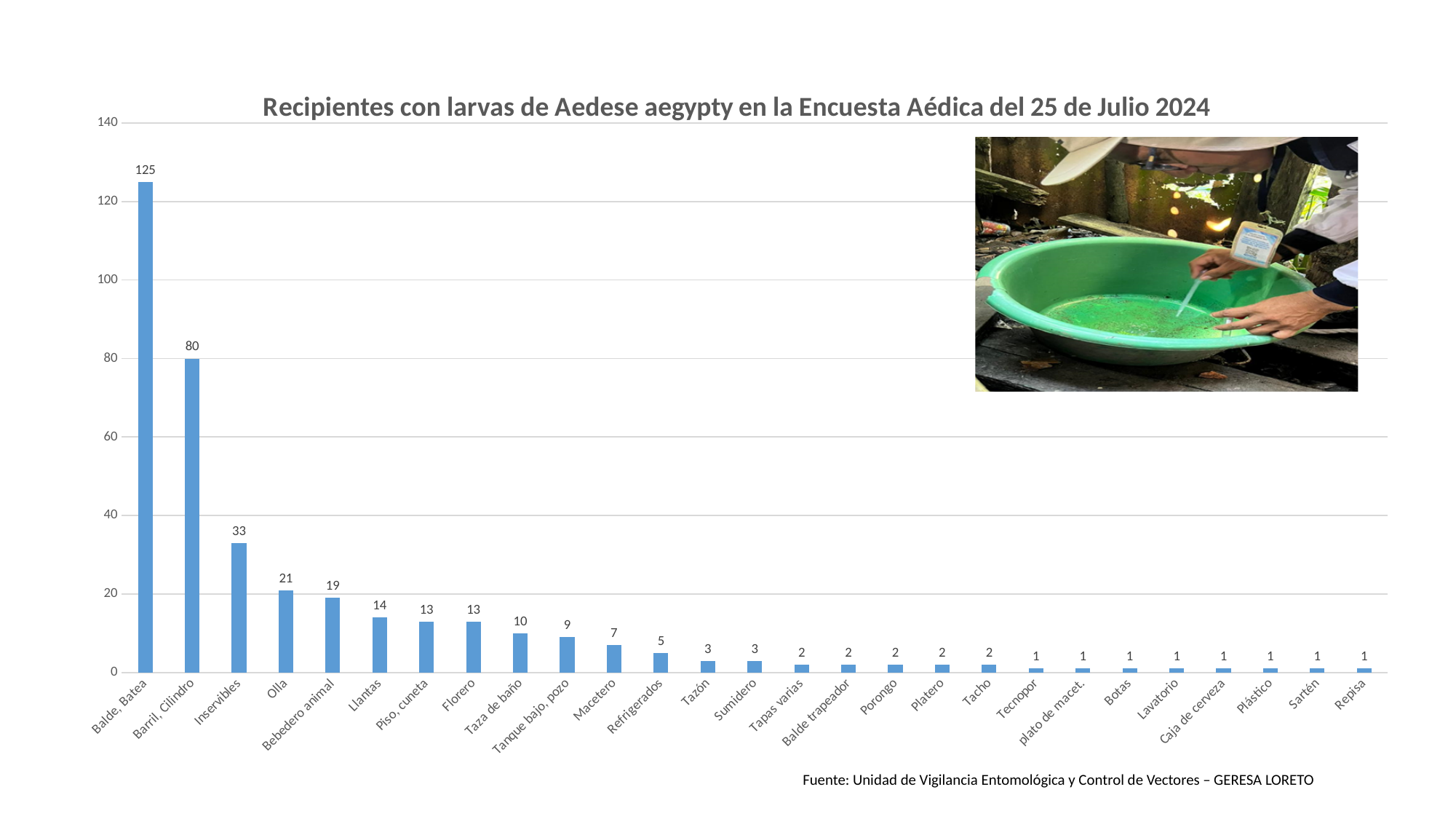
What is the value for Taza de baño? 10 What is the difference between the values for Inservibles and Olla? 12 Which is larger, the value for Llantas or the value for Macetero? Llantas What is the value for Bebedero animal? 19 How many categories are shown on the x axis? 27 Is the value for Inservibles greater or less than 40? less Which category has the highest value? Balde, Batea What is the value for Balde, Batea? 125 What is the title of the chart? Recipientes con larvas de Aedese aegypty en la Encuesta Aédica del 25 de Julio 2024 What is the difference between the values for Balde, Batea and Barril, Cilindro? 45 What is the value for Barril, Cilindro? 80 What kind of chart is shown on the slide? bar chart